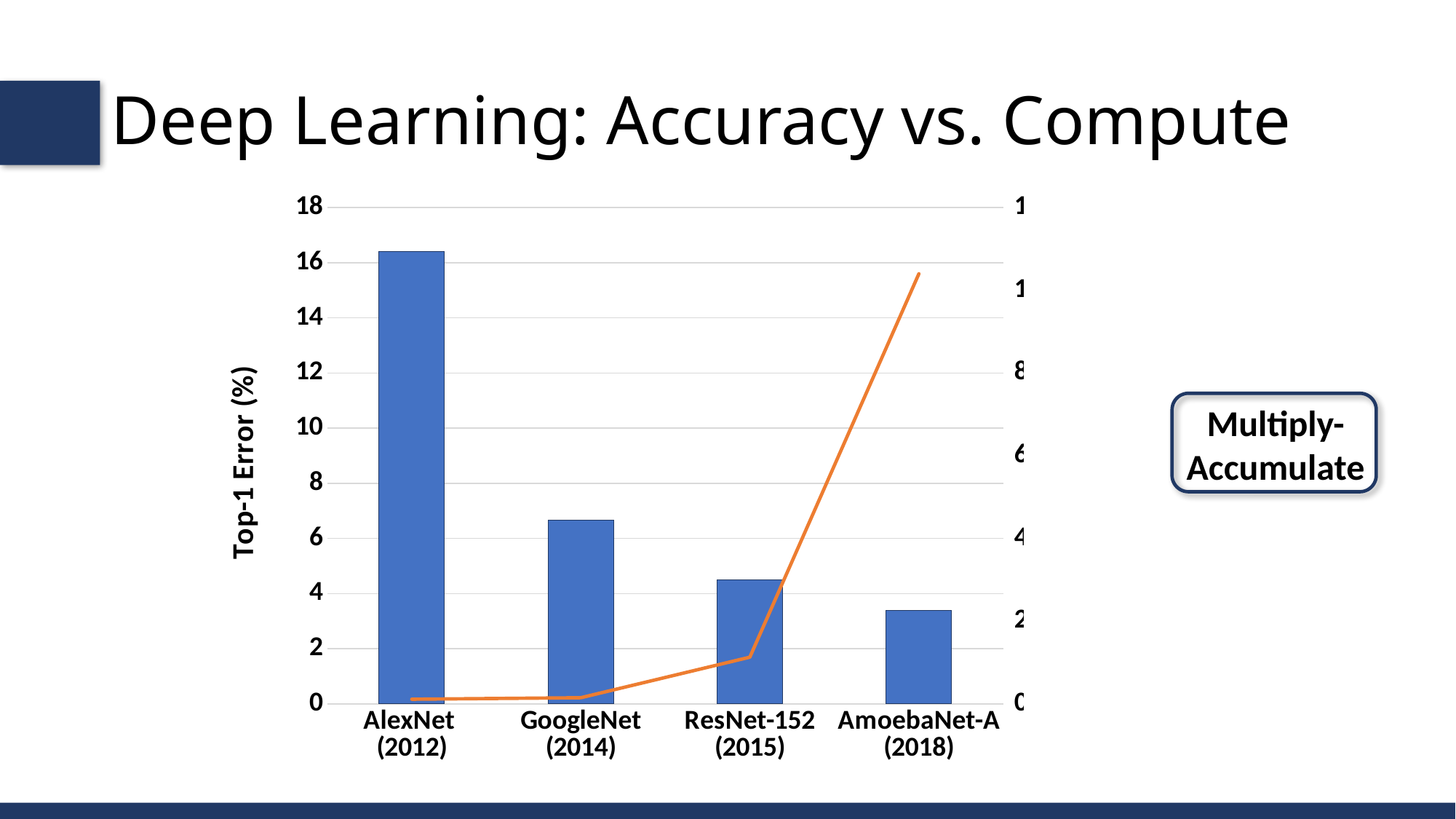
Do the Top-1 Error (%) bars rise or fall from AlexNet (2012) to AmoebaNet-A (2018)? fall What is the label of the left vertical axis? Top-1 Error (%) Does the orange Multiply-Accumulate line rise or fall from AlexNet (2012) to AmoebaNet-A (2018)? rise How many models are shown on the x axis? 4 Which has a higher Top-1 Error (%), GoogleNet (2014) or ResNet-152 (2015)? GoogleNet (2014) Is the Top-1 Error (%) for AmoebaNet-A (2018) greater or less than 4? less Which model has the lowest Top-1 Error (%)? AmoebaNet-A (2018) Is the Top-1 Error (%) for ResNet-152 (2015) greater or less than 4? greater What kind of chart is used to show Top-1 Error (%)? bar chart Is the Top-1 Error (%) for GoogleNet (2014) greater or less than 6? greater Which model has the highest Top-1 Error (%)? AlexNet (2012)